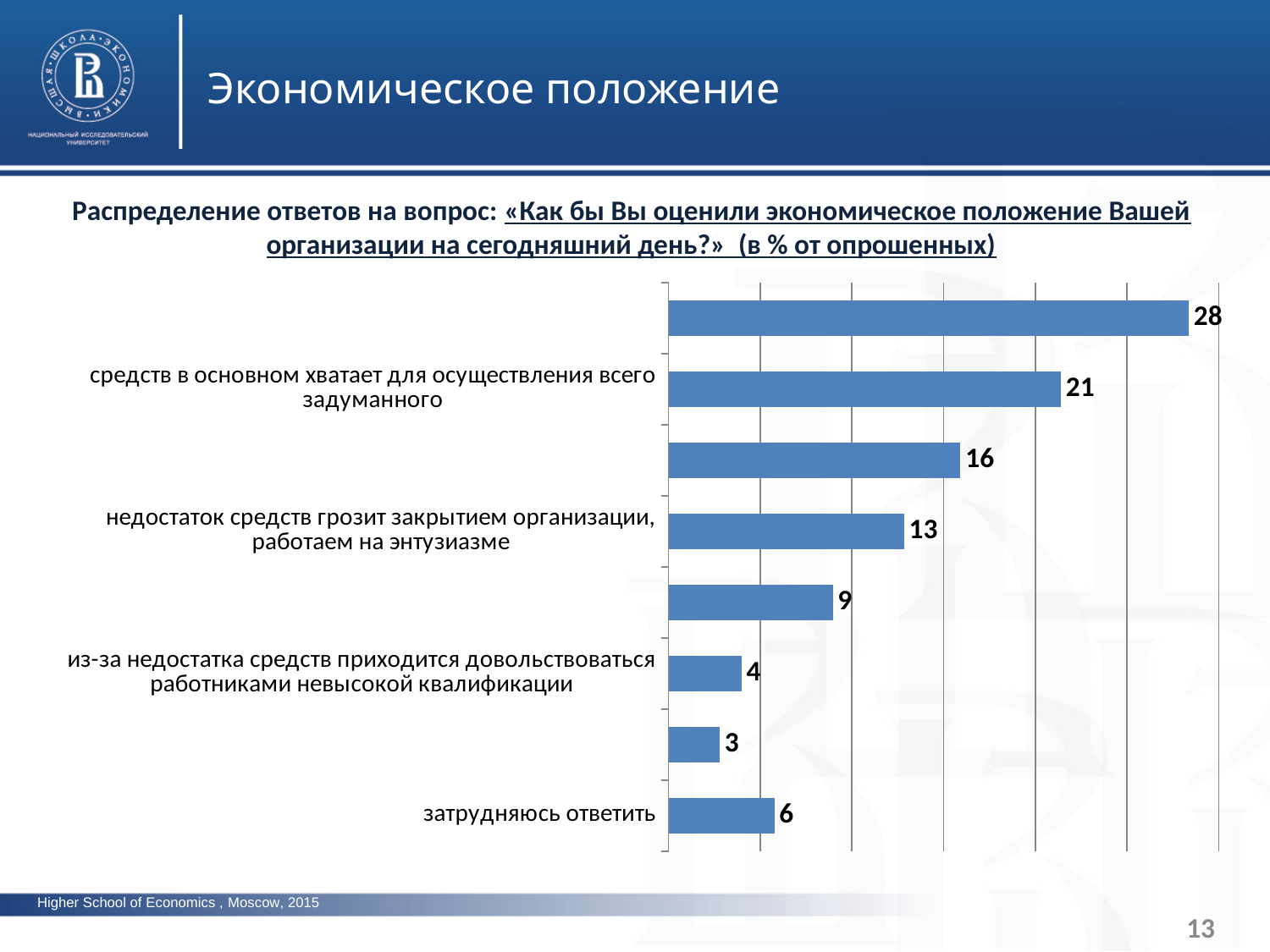
What is the difference between the values for "средств в основном хватает для осуществления всего задуманного" and "недостаток средств грозит закрытием организации, работаем на энтузиазме"? 8 What is the largest value shown on the chart? 28 What kind of chart is shown on the slide? bar chart What is the difference between the values for "недостаток средств грозит закрытием организации, работаем на энтузиазме" and "затрудняюсь ответить"? 7 How many bars does the chart contain? 8 What is the value for "средств в основном хватает для осуществления всего задуманного"? 21 What is the value for "затрудняюсь ответить"? 6 What colour are the bars in the chart? blue What is the smallest value shown on the chart? 3 What is the value for "недостаток средств грозит закрытием организации, работаем на энтузиазме"? 13 What is the value for "из-за недостатка средств приходится довольствоваться работниками невысокой квалификации"? 4 Which is larger: the value for "затрудняюсь ответить" or the value for "из-за недостатка средств приходится довольствоваться работниками невысокой квалификации"? затрудняюсь ответить